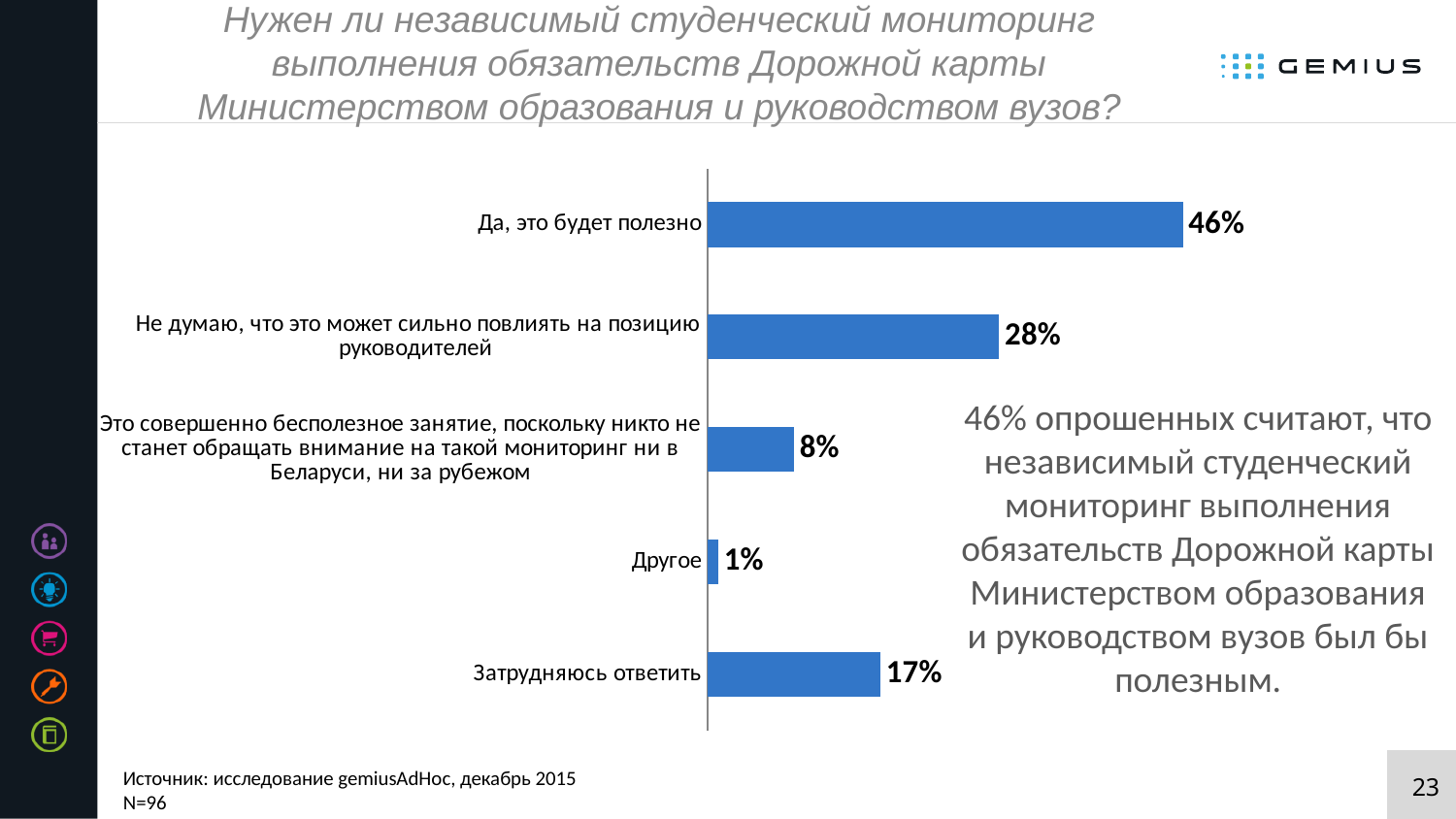
Which category has the lowest value in the chart? Другое What percentage is shown for "Затрудняюсь ответить"? 17% Which category has the highest value in the chart? Да, это будет полезно What value is shown for the category "Другое"? 1% What value is shown for "Не думаю, что это может сильно повлиять на позицию руководителей"? 28% What is the sample size (N) stated on the slide? N=96 What type of chart is shown on the slide? Bar chart Which is larger: the value for "Затрудняюсь ответить" or the value for "Это совершенно бесполезное занятие..."? Затрудняюсь ответить What is the difference between the values for "Затрудняюсь ответить" and "Это совершенно бесполезное занятие, поскольку никто не станет обращать внимание на такой мониторинг ни в Беларуси, ни за рубежом"? 9% How many categories are shown in the chart? 5 What is the difference between the values for "Да, это будет полезно" and "Не думаю, что это может сильно повлиять на позицию руководителей"? 18% What percentage of respondents answered "Да, это будет полезно"? 46%